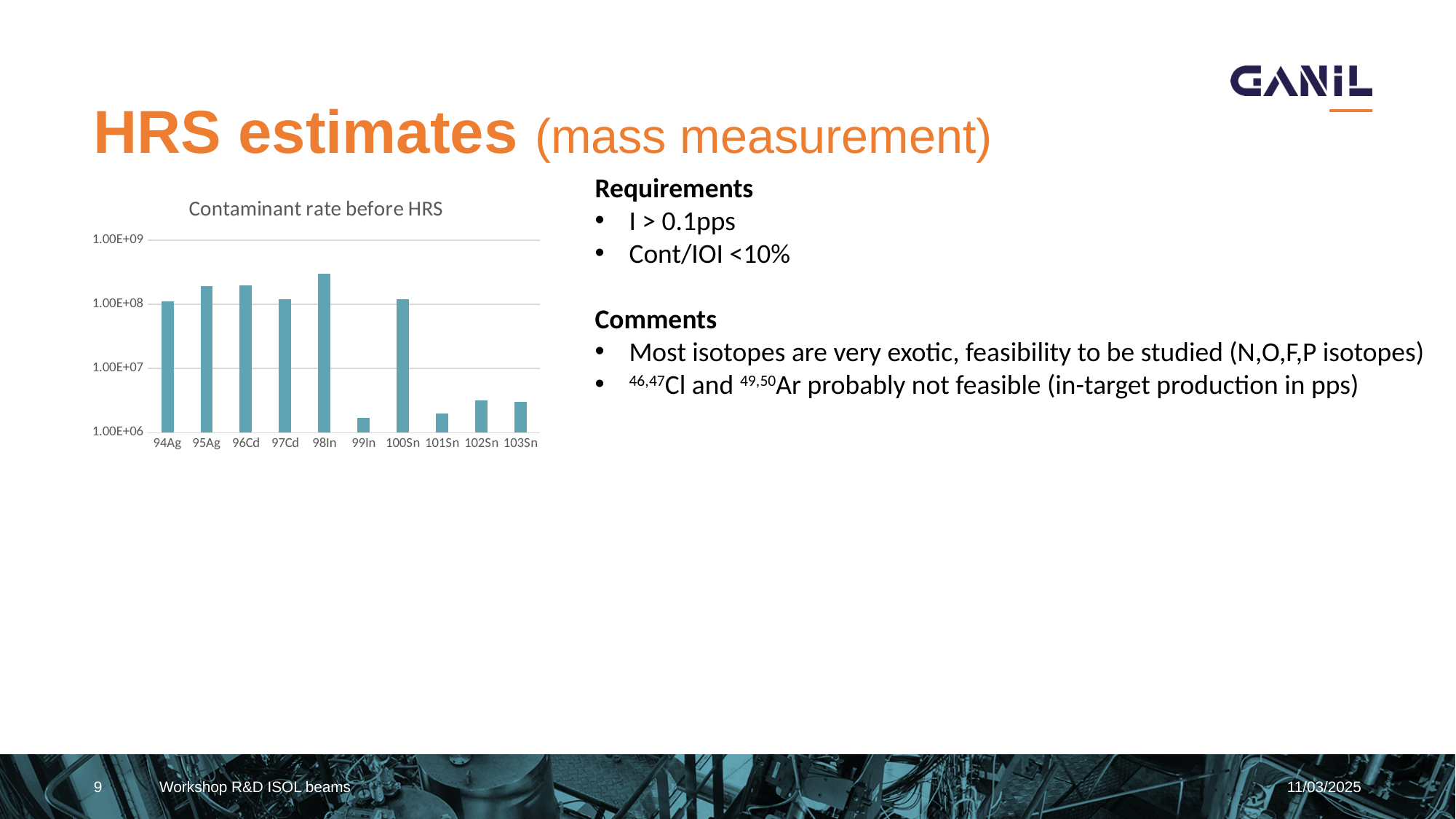
What is the lowest value shown on the y axis of the chart? 1.00E+06 Is the contaminant rate for 95Ag greater or less than 1.00E+08? greater Which isotope has the highest contaminant rate before HRS? 98In Is the contaminant rate for 98In greater or less than 1.00E+08? greater What is the title of the chart on the slide? Contaminant rate before HRS Is the contaminant rate for 99In greater or less than 1.00E+07? less Which isotope has the lowest contaminant rate before HRS? 99In What kind of chart is shown on the slide? bar chart Which has a lower contaminant rate before HRS, 98In or 103Sn? 103Sn Which has a higher contaminant rate before HRS, 96Cd or 101Sn? 96Cd How many isotopes are plotted on the x axis of the chart? 10